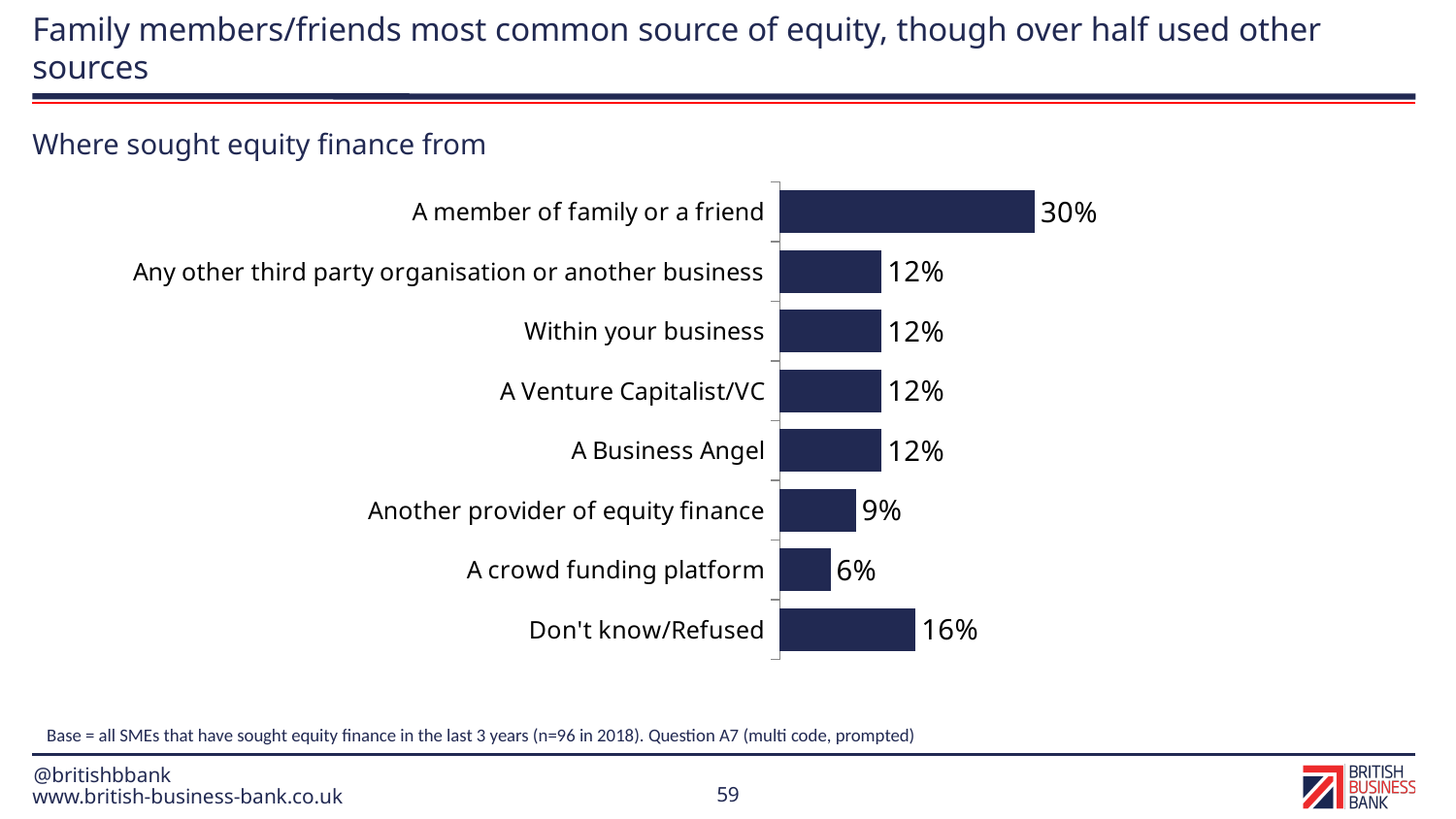
What is the value for 'A crowd funding platform'? 6% Which source of equity finance has the highest value? A member of family or a friend Which category has the lowest value? A crowd funding platform What is the value for 'Don't know/Refused'? 16% Which is larger: the value for 'Don't know/Refused' or the value for 'A Venture Capitalist/VC'? Don't know/Refused What is the title of the chart? Where sought equity finance from What is the difference between the value for 'A member of family or a friend' and the value for 'A Business Angel'? 18% What is the value for 'Another provider of equity finance'? 9% How many categories are shown in the chart? 8 What kind of chart is shown on the slide? Bar chart How many categories share the value 12%? 4 What percentage of SMEs sought equity finance from a member of family or a friend? 30%